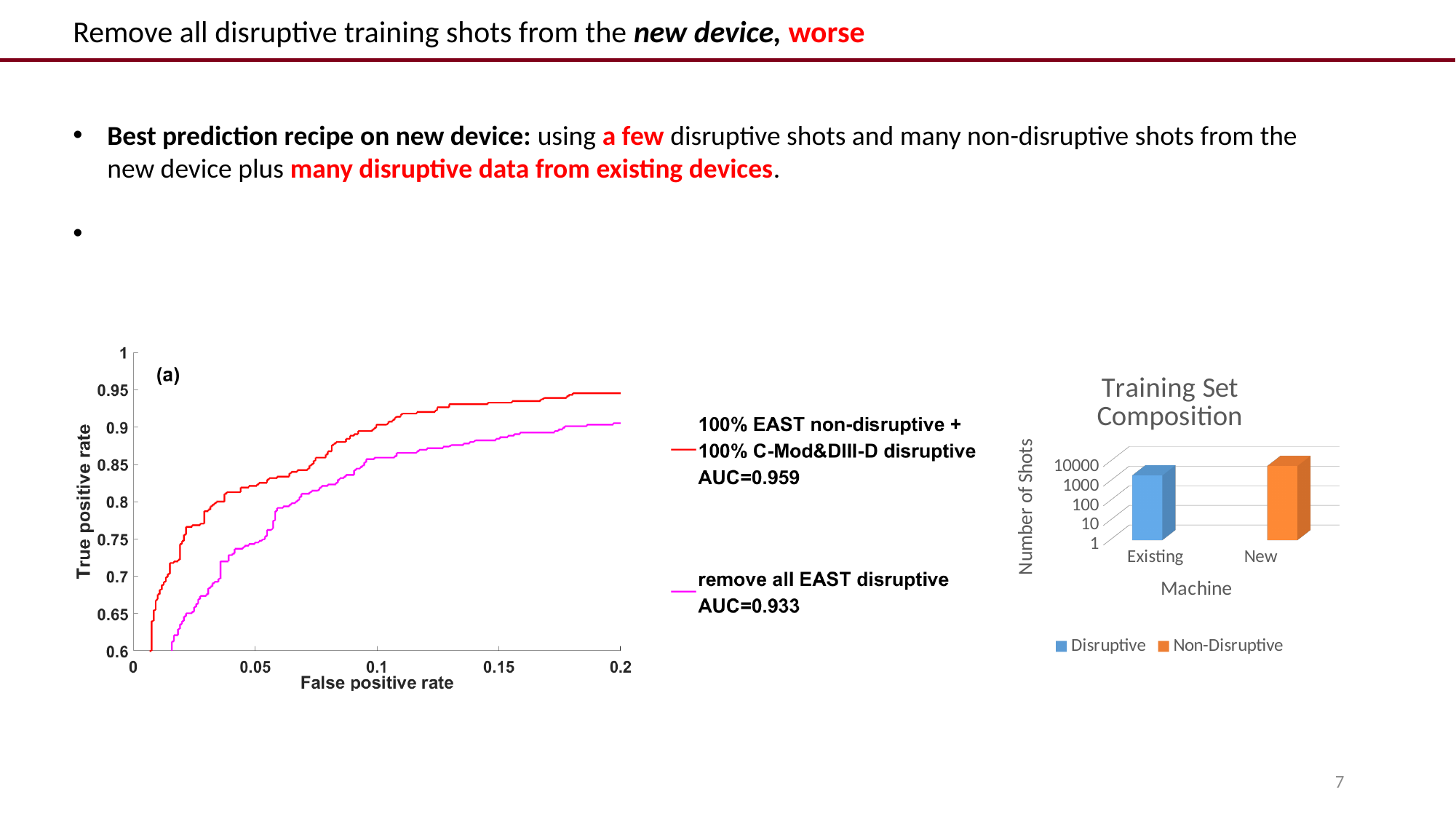
How many series does the legend of the 'Training Set Composition' chart list? 2 In the left ROC chart, what is the AUC of the 'remove all EAST disruptive' curve? AUC=0.933 In the 'Training Set Composition' chart, is the value for Existing greater or less than 100? greater In the left ROC chart, does the true positive rate rise or fall as the false positive rate increases? Rise What kind of chart is the 'Training Set Composition' chart on the right? Bar chart In the left ROC chart, what is the difference between the two AUC values shown? 0.026 What kind of chart is the chart on the left with True positive rate on the y axis? Line chart In the 'Training Set Composition' chart, which machine has the taller bar, Existing or New? New In the 'Training Set Composition' chart, is the value for New greater or less than 1000? greater In the left ROC chart, what is the AUC of the red curve (100% EAST non-disruptive + 100% C-Mod&DIII-D disruptive)? AUC=0.959 In the 'Training Set Composition' chart, which series is shown in orange? Non-Disruptive How many machine categories are shown on the x axis of the 'Training Set Composition' chart? 2